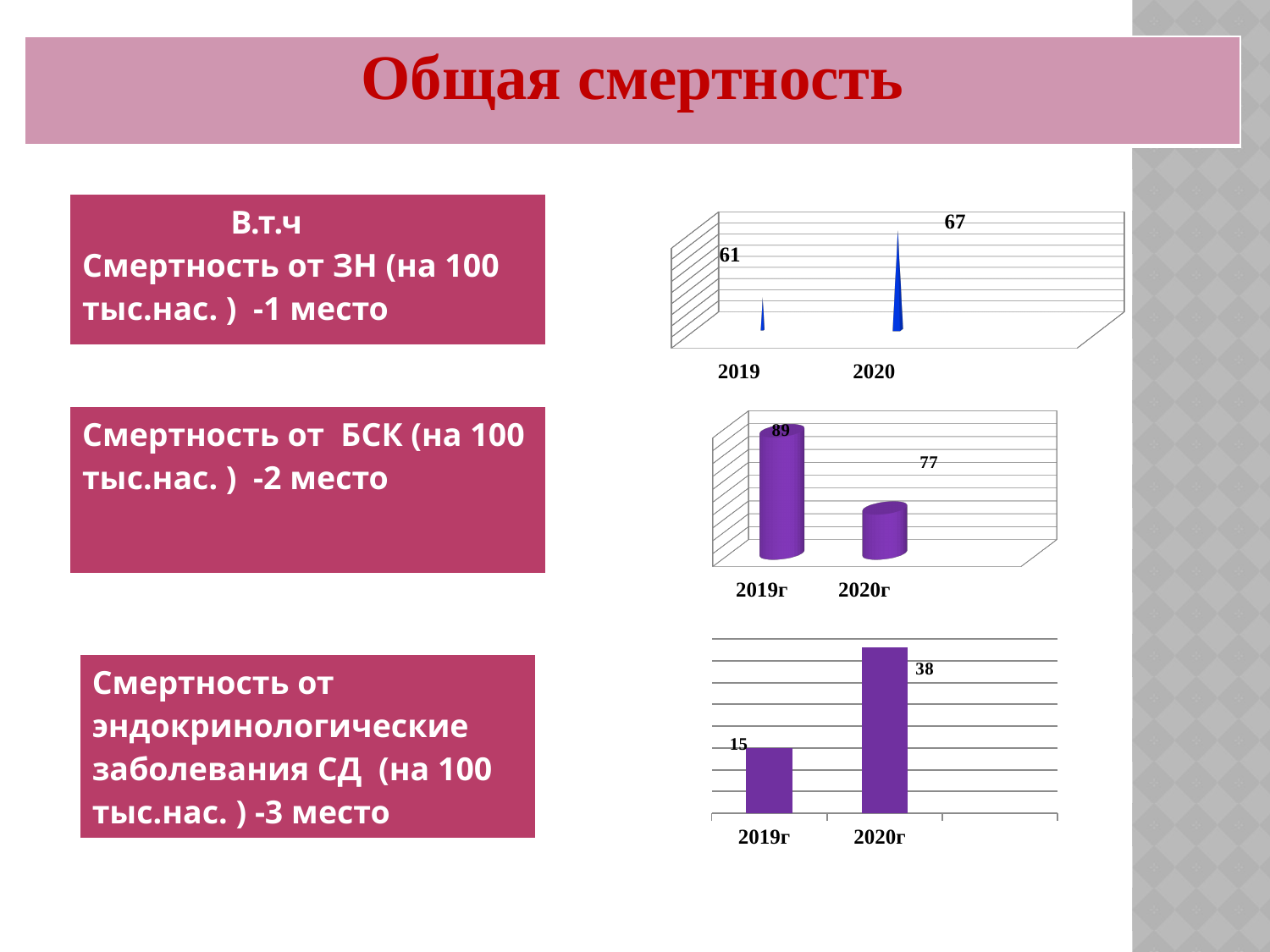
In the top chart, what is the difference between the 2020 and 2019 values? 6 In the bottom chart, what is the value for 2020г? 38 What kind of chart is the bottom chart? bar chart In the bottom chart, what is the value for 2019г? 15 In the middle chart, which year has the higher value? 2019г In the top chart, what is the value for 2020? 67 In the top chart, do the values rise or fall from 2019 to 2020? rise In the middle chart, what is the value for 2019г? 89 In the middle chart, what is the value for 2020г? 77 In the bottom chart, which year has the lower value? 2019г In the top chart, what is the value for 2019? 61 In the middle chart, what is the difference between the 2019г and 2020г values? 12